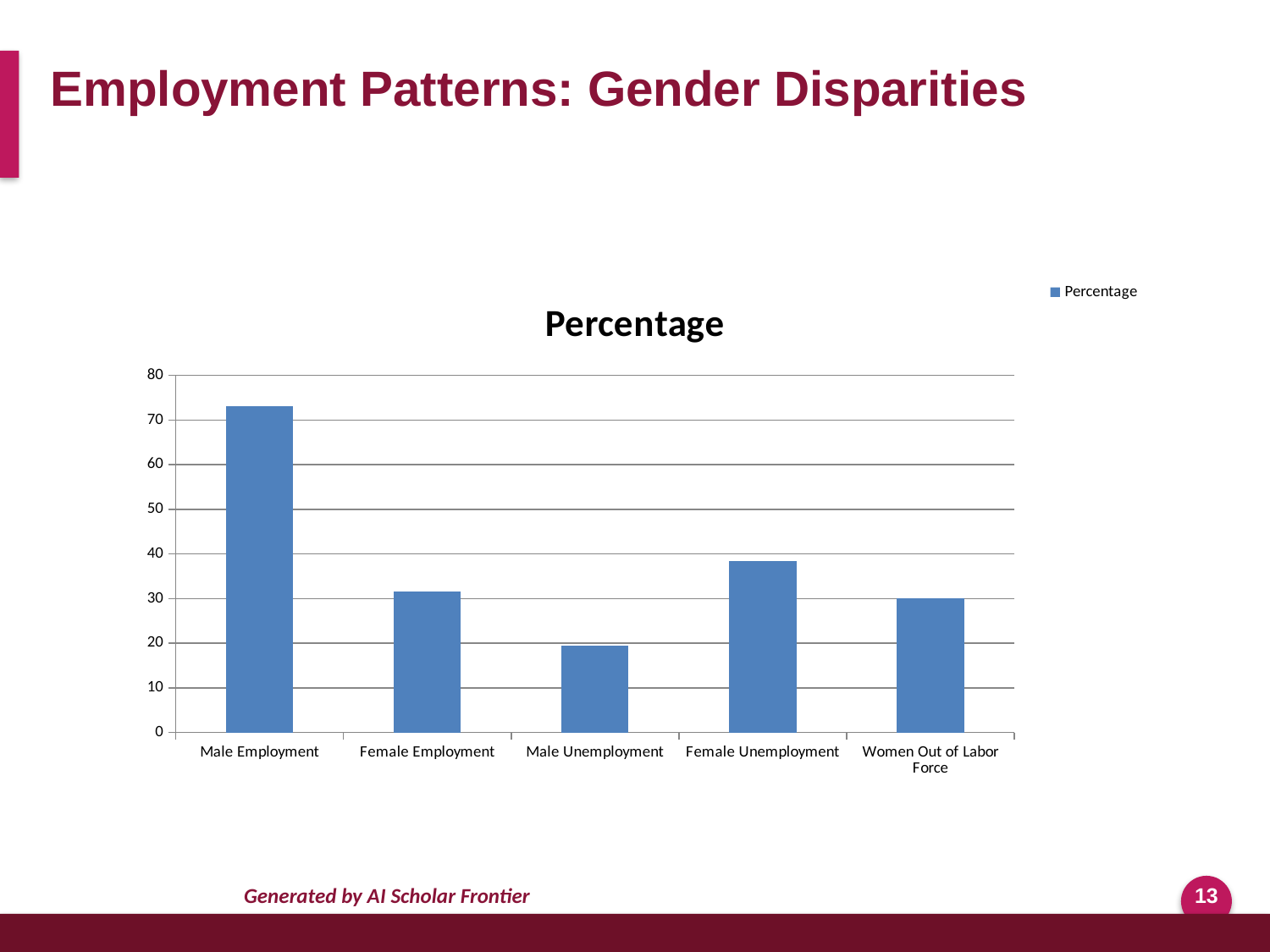
How many series does the chart's legend list? 1 Which category has the highest value in the chart? Male Employment Which is larger, the value for Female Unemployment or the value for Male Unemployment? Female Unemployment Is the value for Male Employment greater or less than 70? greater Which category has the lowest value in the chart? Male Unemployment Is the value for Female Unemployment greater or less than 40? less What is the name of the series shown in the chart's legend? Percentage How many categories are plotted on the x axis of the chart? 5 What kind of chart is shown on the slide? bar chart What is the title of the chart? Percentage Which is larger, the value for Male Employment or the value for Female Employment? Male Employment